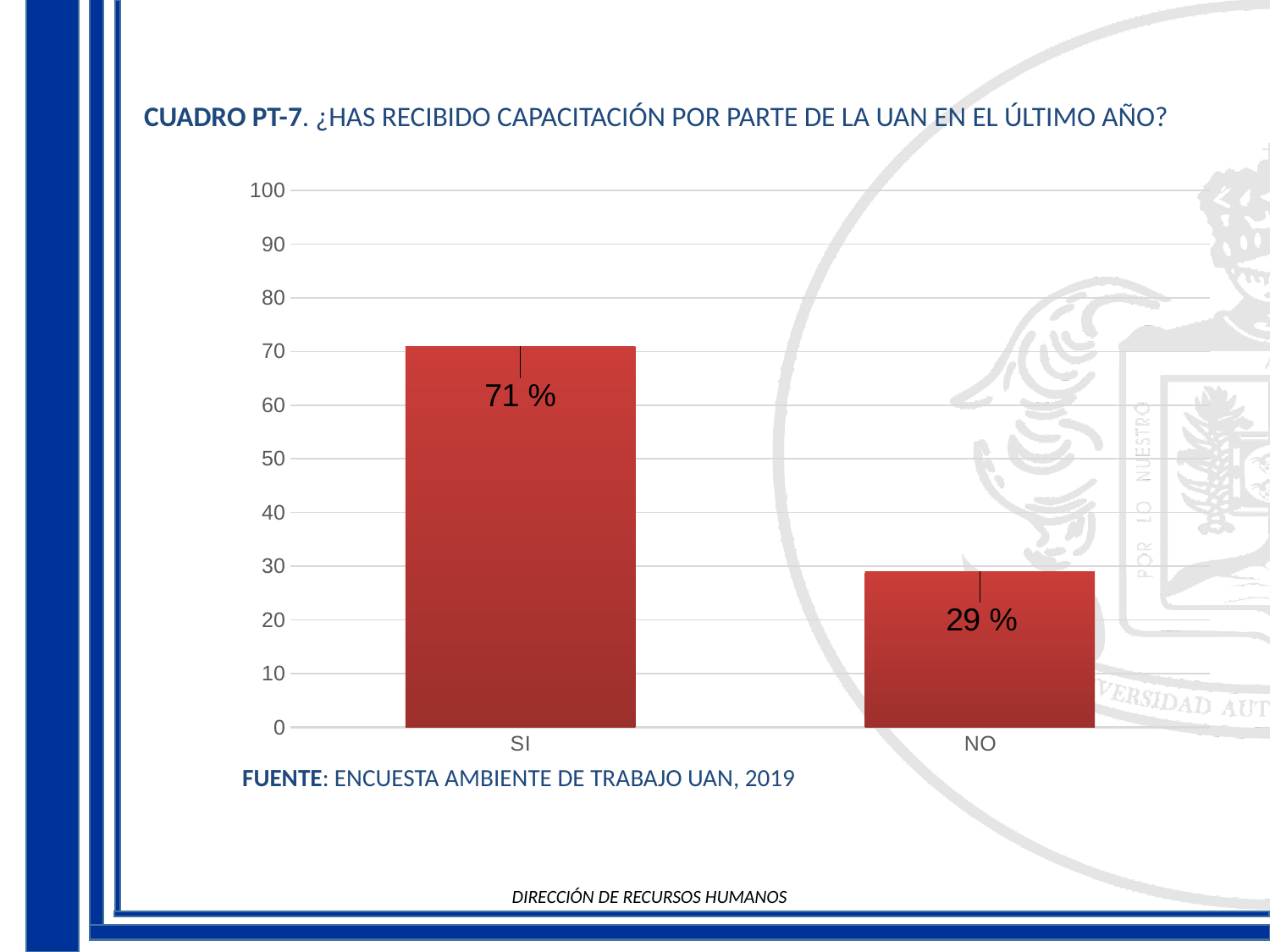
What source is cited below the chart? ENCUESTA AMBIENTE DE TRABAJO UAN, 2019 What is the value for NO? 29 % What is the value for SI? 71 % Which is larger, the value for SI or the value for NO? SI What is the difference between the values for SI and NO? 42 % Is the value for SI greater or less than 70? greater Which category has the highest value? SI Which category has the lowest value? NO What kind of chart is shown on the slide? bar chart What is the highest value shown on the y axis? 100 How many categories are shown on the x axis? 2 Is the value for NO greater or less than 30? less